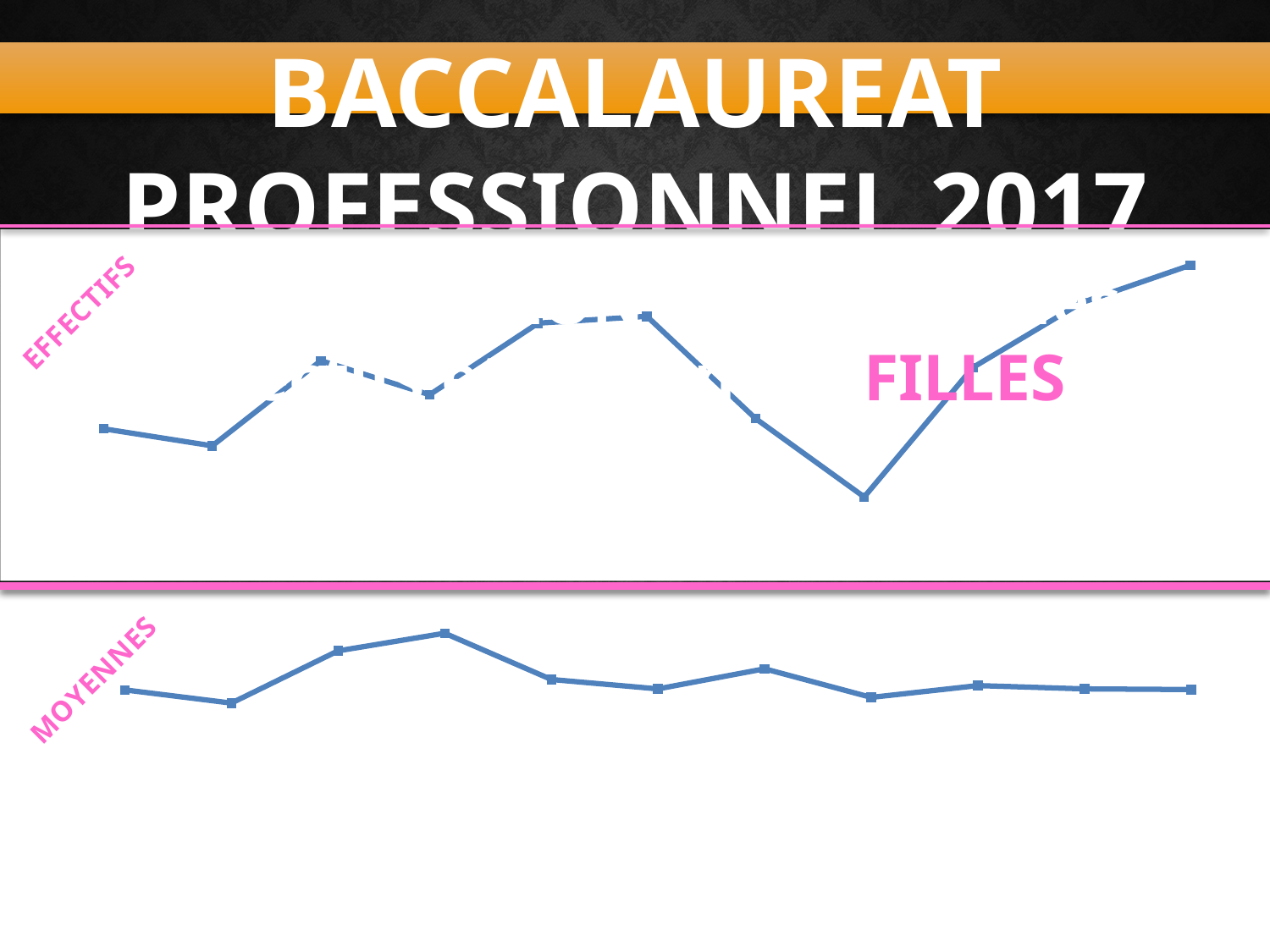
On the bottom chart labelled MOYENNES, which point is the highest: the 4th point or the last point? the 4th point How many data points are plotted on the bottom chart labelled MOYENNES? 11 On the top chart labelled EFFECTIFS, where is the highest point located: at the left end or the right end of the line? right end What kind of chart is the top chart labelled EFFECTIFS? line chart What kind of chart is the bottom chart labelled MOYENNES? line chart On the top chart labelled EFFECTIFS, is the second point higher or lower than the first point? lower What word is written in large pink letters over the top chart? FILLES What label is written in pink rotated text next to the top chart? EFFECTIFS On the bottom chart labelled MOYENNES, does the line rise or fall between the 2nd and 4th points? rise On the top chart labelled EFFECTIFS, is the last point higher or lower than the first point? higher